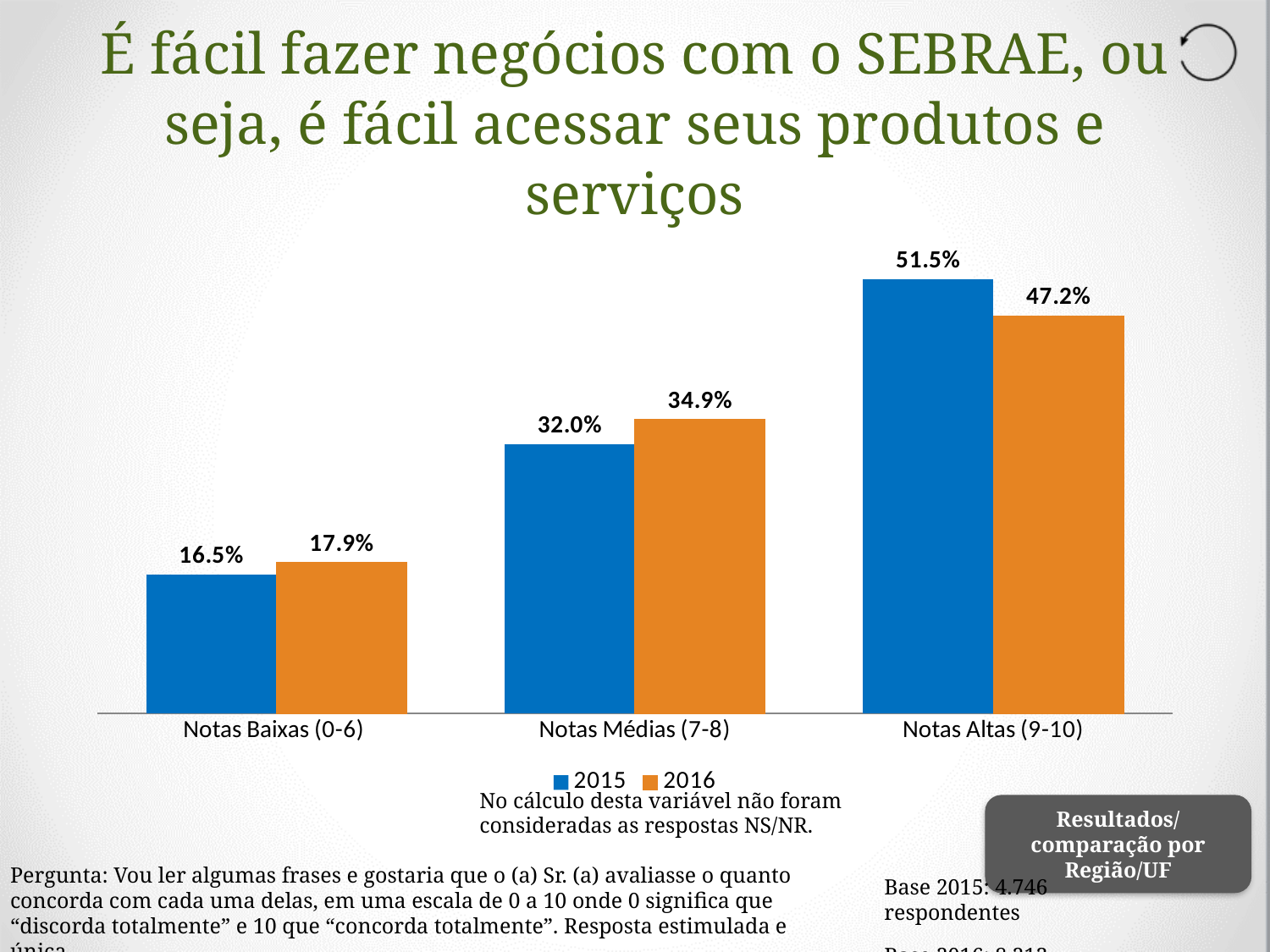
What is the value for Notas Médias (7-8) in 2016? 34.9% What kind of chart is shown on the slide? Bar chart What is the value for Notas Altas (9-10) in 2016? 47.2% Do the 2016 values rise or fall from Notas Baixas (0-6) to Notas Altas (9-10)? Rise How many series does the legend list? 2 What is the difference between the 2015 and 2016 values for Notas Altas (9-10)? 4.3 percentage points Which category has the highest value for 2015? Notas Altas (9-10) How many categories are shown on the x axis? 3 Which category has the lowest value for 2016? Notas Baixas (0-6) Which colour represents the 2016 series in the legend? Orange What is the value for Notas Baixas (0-6) in 2015? 16.5% For Notas Médias (7-8), which year has the larger value, 2015 or 2016? 2016